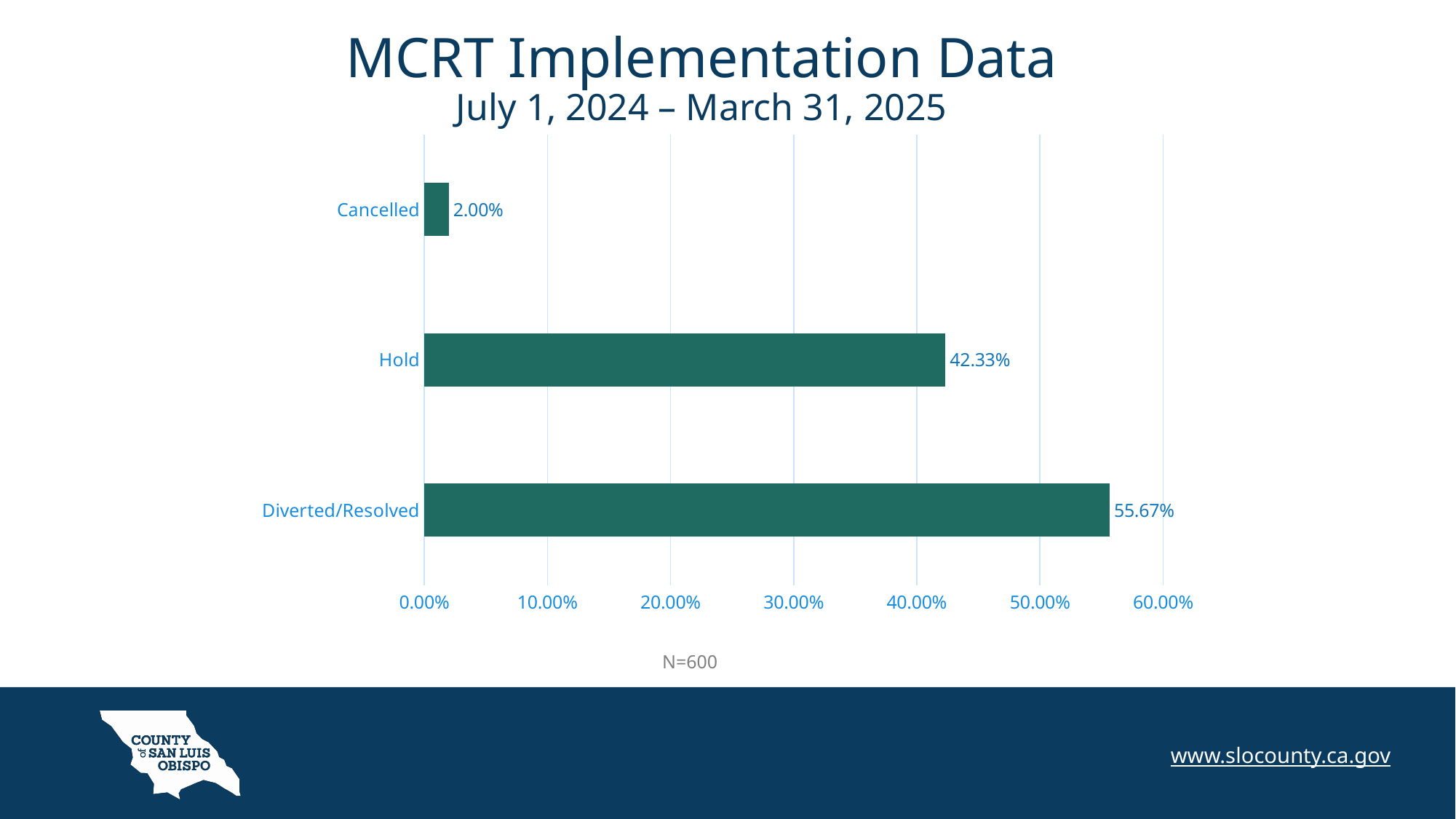
What is the value for Cancelled? 2.00% What is the value for Hold? 42.33% What is the difference between the values for Diverted/Resolved and Hold? 13.34% Which category has the lowest value? Cancelled What kind of chart is shown on the slide? bar chart How many categories are shown in the chart? 3 Which category has the highest value? Diverted/Resolved What is the value for Diverted/Resolved? 55.67% Which is larger, the value for Hold or the value for Cancelled? Hold What sample size is noted below the chart? N=600 Is the value for Hold greater or less than 40.00%? greater What is the difference between the values for Hold and Cancelled? 40.33%